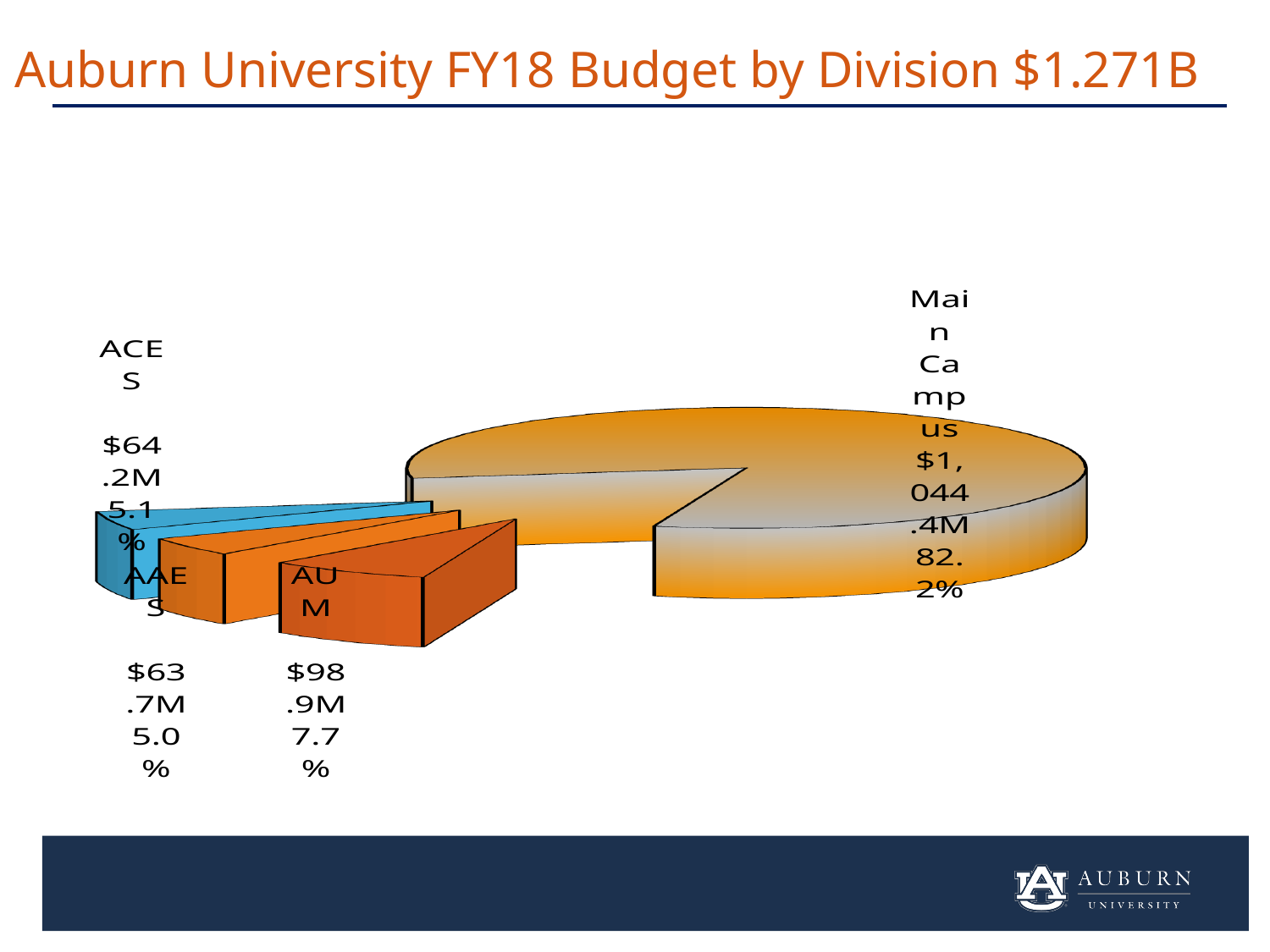
Which has a larger budget, AUM or ACES? AUM Which division has the largest slice of the pie? Main Campus What is the budget amount for Main Campus? $1,044.4M How many slices does the pie chart have? 4 What is the title of the chart on the slide? Auburn University FY18 Budget by Division $1.271B What is the budget amount for AUM? $98.9M What share of the pie does AUM hold? 7.7% What share of the pie does AAES hold? 5.0% What kind of chart is shown on the slide? pie chart What is the budget amount for ACES? $64.2M Which division has the smallest slice of the pie? AAES What percentage of the budget does Main Campus represent? 82.2%